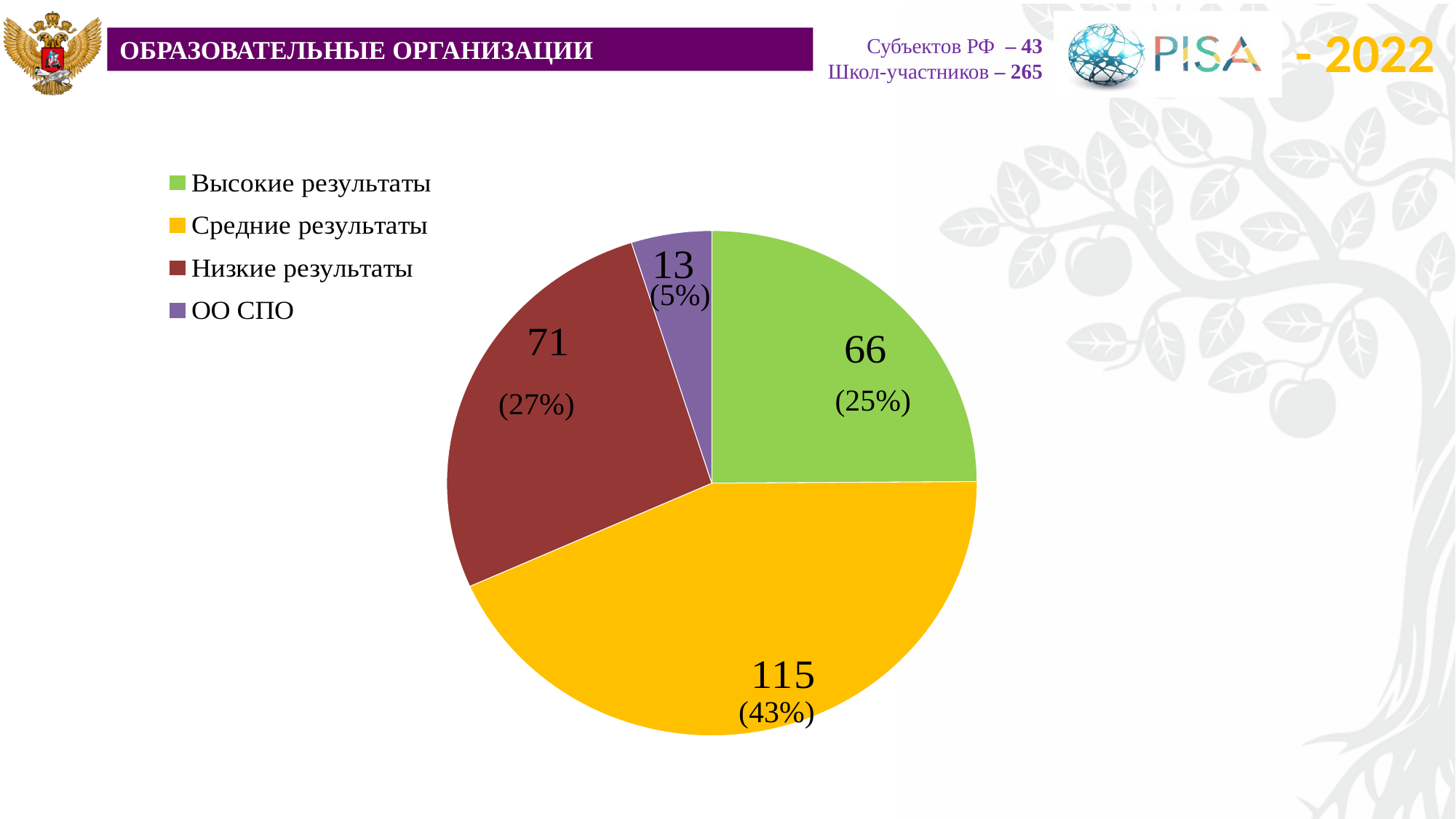
What is the value for Низкие результаты? 71 How many slices does the pie chart have? 4 Which category has the largest slice? Средние результаты Which colour represents ОО СПО in the legend? purple What is the value for Высокие результаты? 66 What is the value for Средние результаты? 115 What share of the pie does Высокие результаты represent? 25% What kind of chart is shown on the slide? pie chart What is the difference between the values for Средние результаты and Низкие результаты? 44 What share of the pie does Низкие результаты represent? 27% Which category has the smallest slice? ОО СПО What is the value for ОО СПО? 13